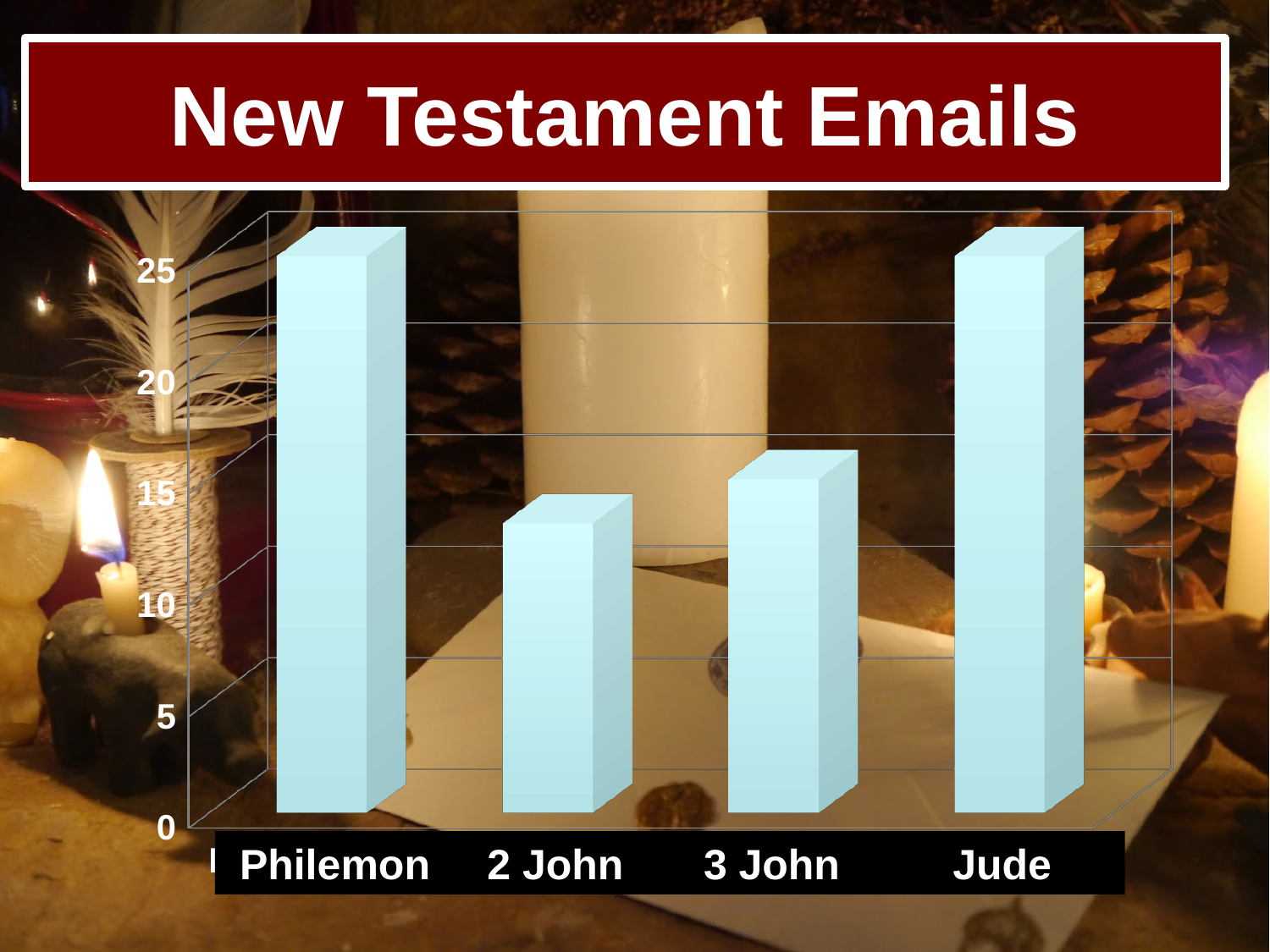
Is the value for Philemon greater or less than 20? greater Is the value for 2 John greater or less than 20? less How many categories are plotted on the chart? 4 Is the value for Jude greater or less than 20? greater What kind of chart is shown on the slide? bar chart What is the highest value shown on the vertical axis? 25 Which is larger, the value for 2 John or the value for 3 John? 3 John Which category has the lowest value? 2 John What is the title of the slide? New Testament Emails